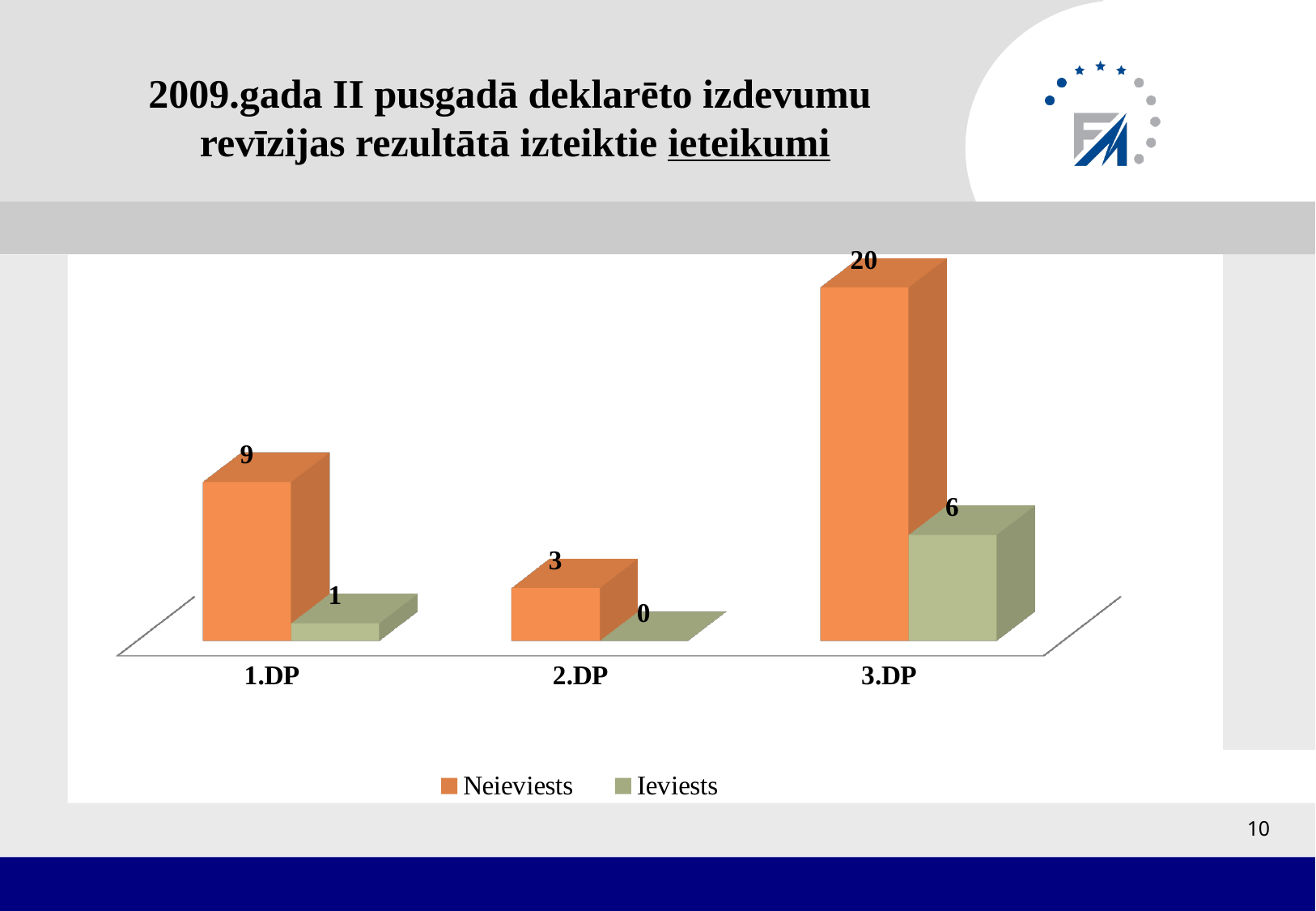
Which category has the highest Neieviests value? 3.DP How many categories are shown on the x axis? 3 What kind of chart is shown on the slide? bar chart What is the Ieviests value for 3.DP? 6 Which is larger: the Neieviests value for 1.DP or the Neieviests value for 2.DP? 1.DP What is the Ieviests value for 1.DP? 1 Which colour represents the Ieviests series? green Which category has the lowest Ieviests value? 2.DP What is the Neieviests value for 3.DP? 20 What is the difference between the Neieviests and Ieviests values for 3.DP? 14 What is the Neieviests value for 2.DP? 3 How many series does the legend list? 2